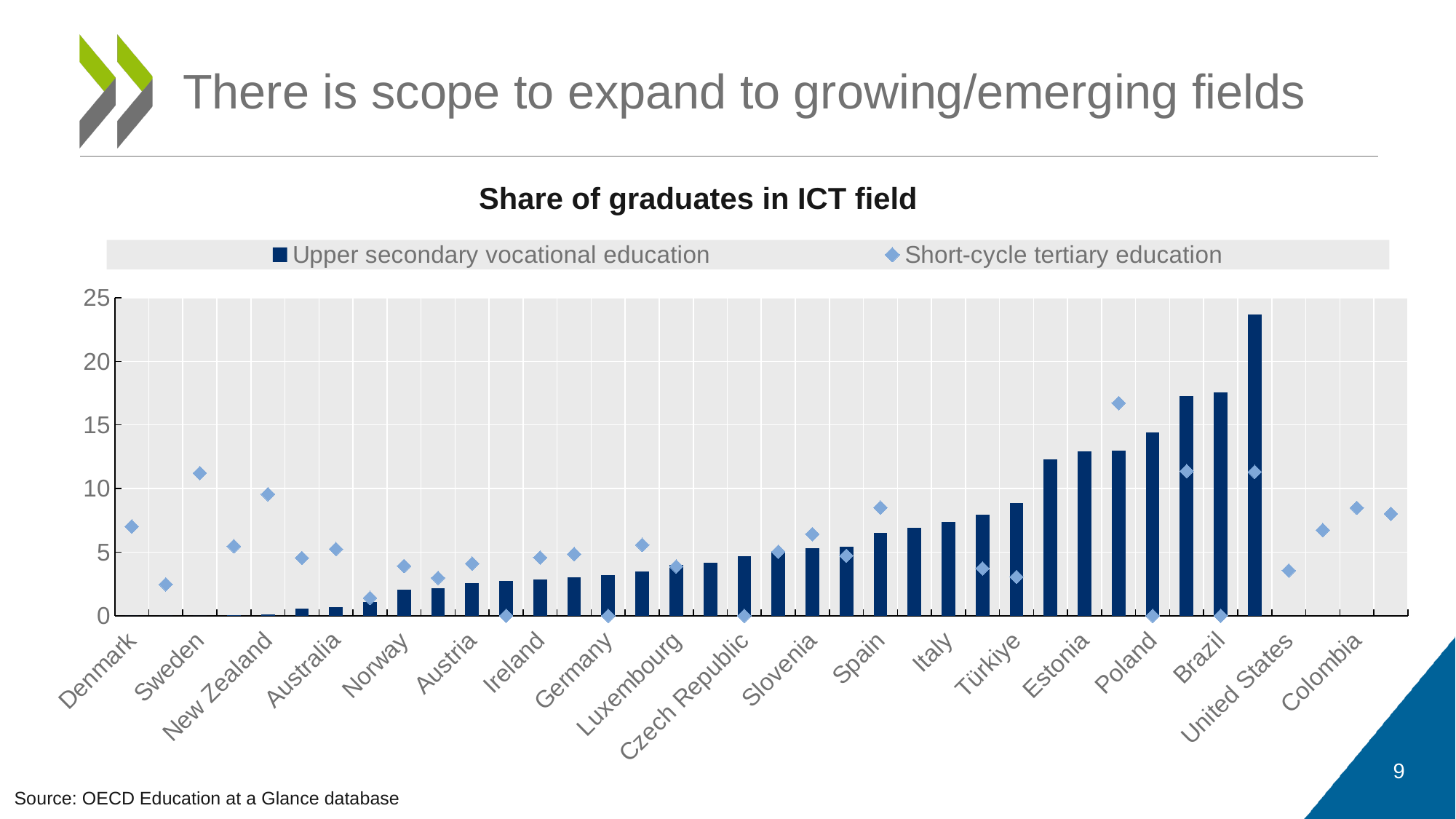
Is the Short-cycle tertiary education value for Denmark greater or less than 5? greater How many series does the chart legend list? 2 What kind of chart is shown on the slide? Bar chart Which series is shown with diamond markers rather than bars? Short-cycle tertiary education Is the Upper secondary vocational education value for Norway greater or less than 5? less Which country has the larger Short-cycle tertiary education value, Denmark or Norway? Denmark Is the Upper secondary vocational education value for Poland greater or less than 10? greater What is the title of the chart? Share of graduates in ICT field Do the Upper secondary vocational education bars generally rise or fall from left to right across the countries? Rise Which country has the larger Upper secondary vocational education value, Brazil or Norway? Brazil